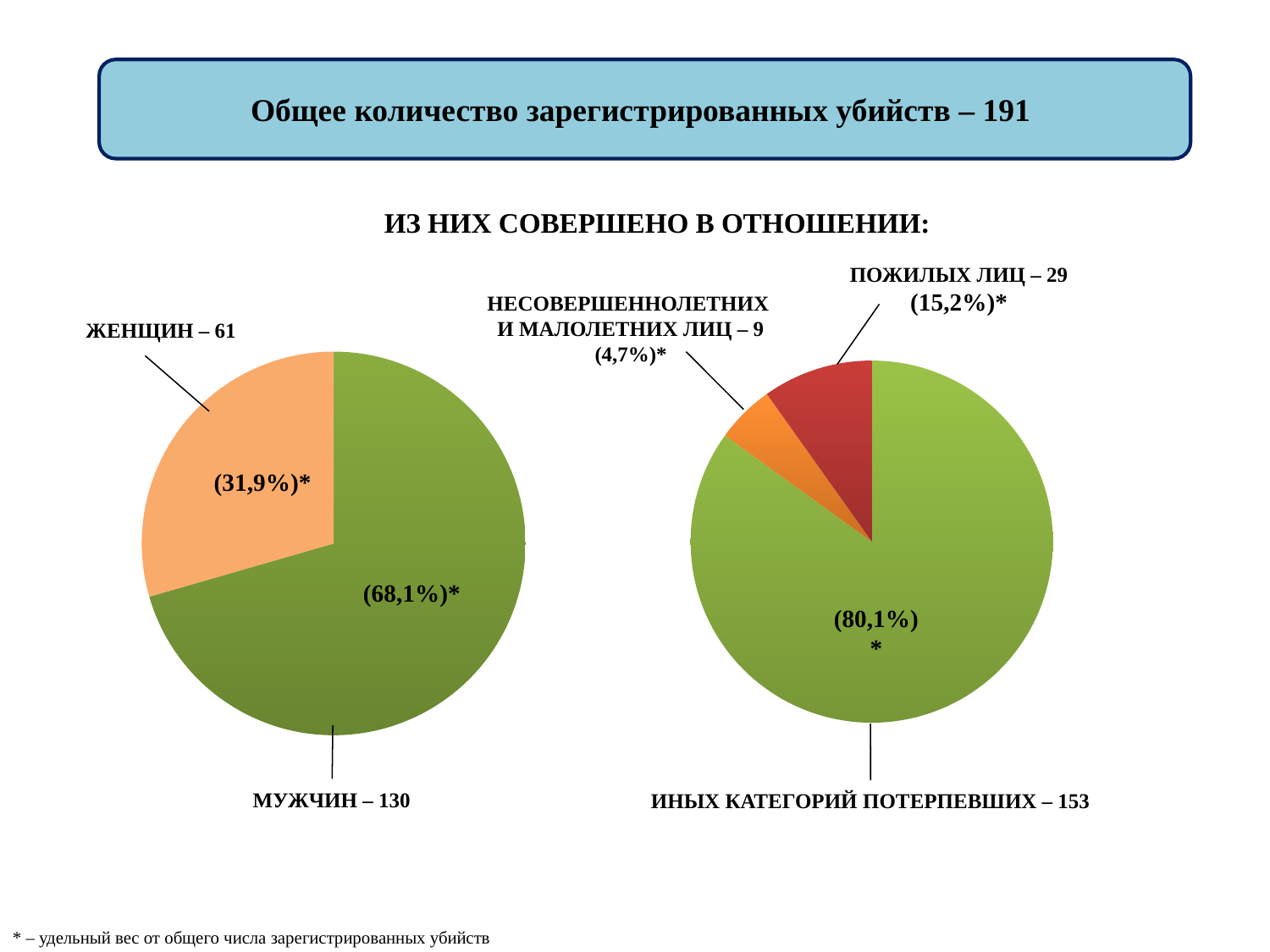
What is the total number of registered murders stated at the top of the slide? 191 On the left pie chart, how many murders were committed against women (ЖЕНЩИН)? 61 On the right pie chart, what share of the total do other categories of victims (ИНЫХ КАТЕГОРИЙ ПОТЕРПЕВШИХ) represent? 80,1% What type of charts are shown on the slide? Pie charts On the right pie chart, how many murders were committed against minors and juveniles (НЕСОВЕРШЕННОЛЕТНИХ И МАЛОЛЕТНИХ ЛИЦ)? 9 On the right pie chart, how many murders were committed against elderly persons (ПОЖИЛЫХ ЛИЦ)? 29 On the left pie chart, what is the difference between the number of male and female victims? 69 On the left pie chart, what share of the total do murders against men (МУЖЧИН) represent? 68,1% On the right pie chart, which category has the smallest number of victims? НЕСОВЕРШЕННОЛЕТНИХ И МАЛОЛЕТНИХ ЛИЦ On the left pie chart, how many murders were committed against men (МУЖЧИН)? 130 On the right pie chart, how many categories are shown? 3 On the left pie chart, what share of the total do murders against women (ЖЕНЩИН) represent? 31,9%